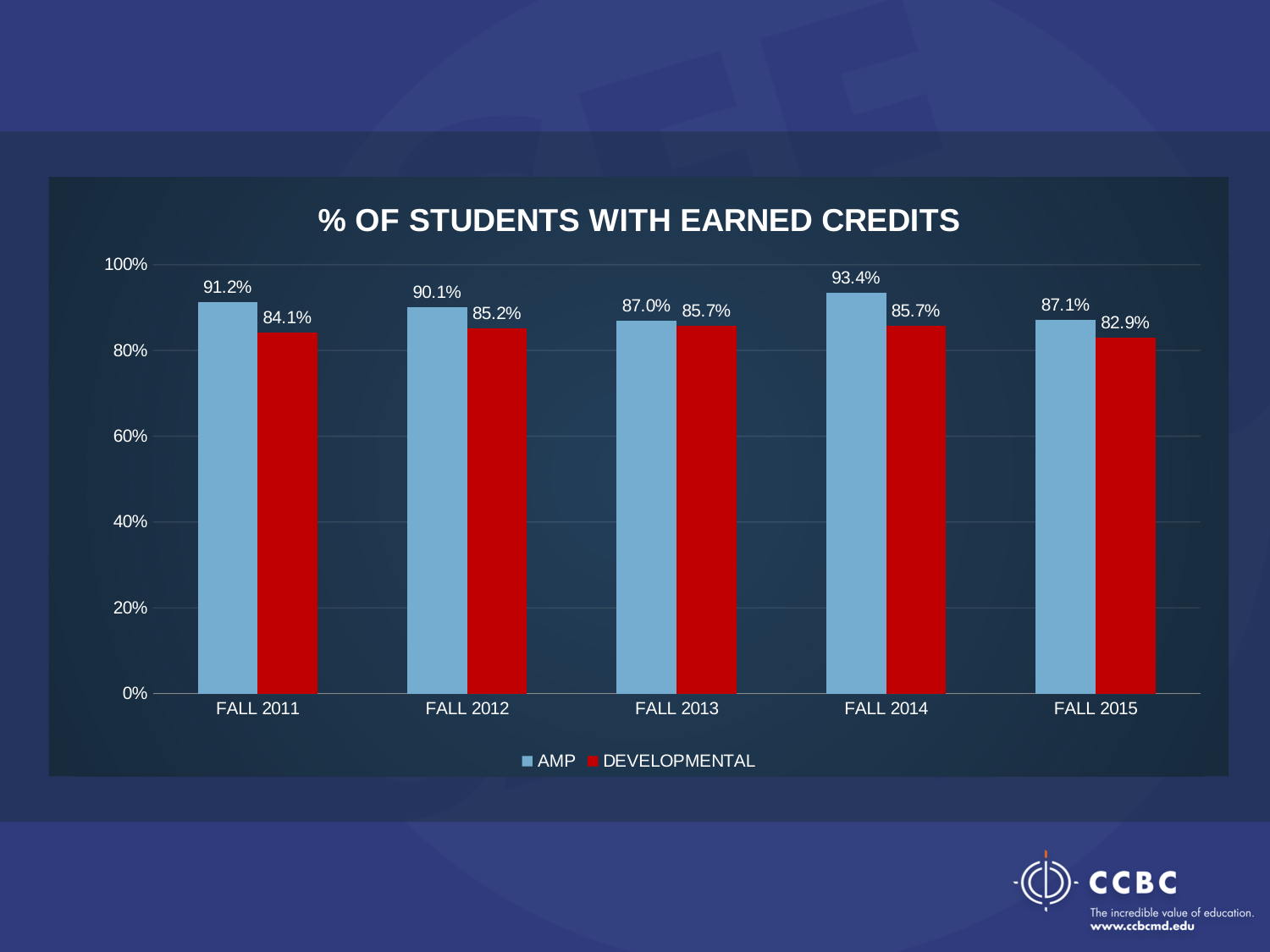
In which term is the DEVELOPMENTAL value lowest? FALL 2015 Is the DEVELOPMENTAL value for FALL 2011 greater or less than 80%? greater What kind of chart is shown on the slide? bar chart What is the difference between the AMP and DEVELOPMENTAL values for FALL 2014? 7.7% What is the title of the chart? % OF STUDENTS WITH EARNED CREDITS How many terms are shown on the x axis? 5 What is the DEVELOPMENTAL value for FALL 2015? 82.9% What is the AMP value for FALL 2013? 87.0% Which is larger for FALL 2012, the AMP value or the DEVELOPMENTAL value? AMP What is the AMP value for FALL 2011? 91.2% How many series does the legend list? 2 In which term is the AMP value highest? FALL 2014